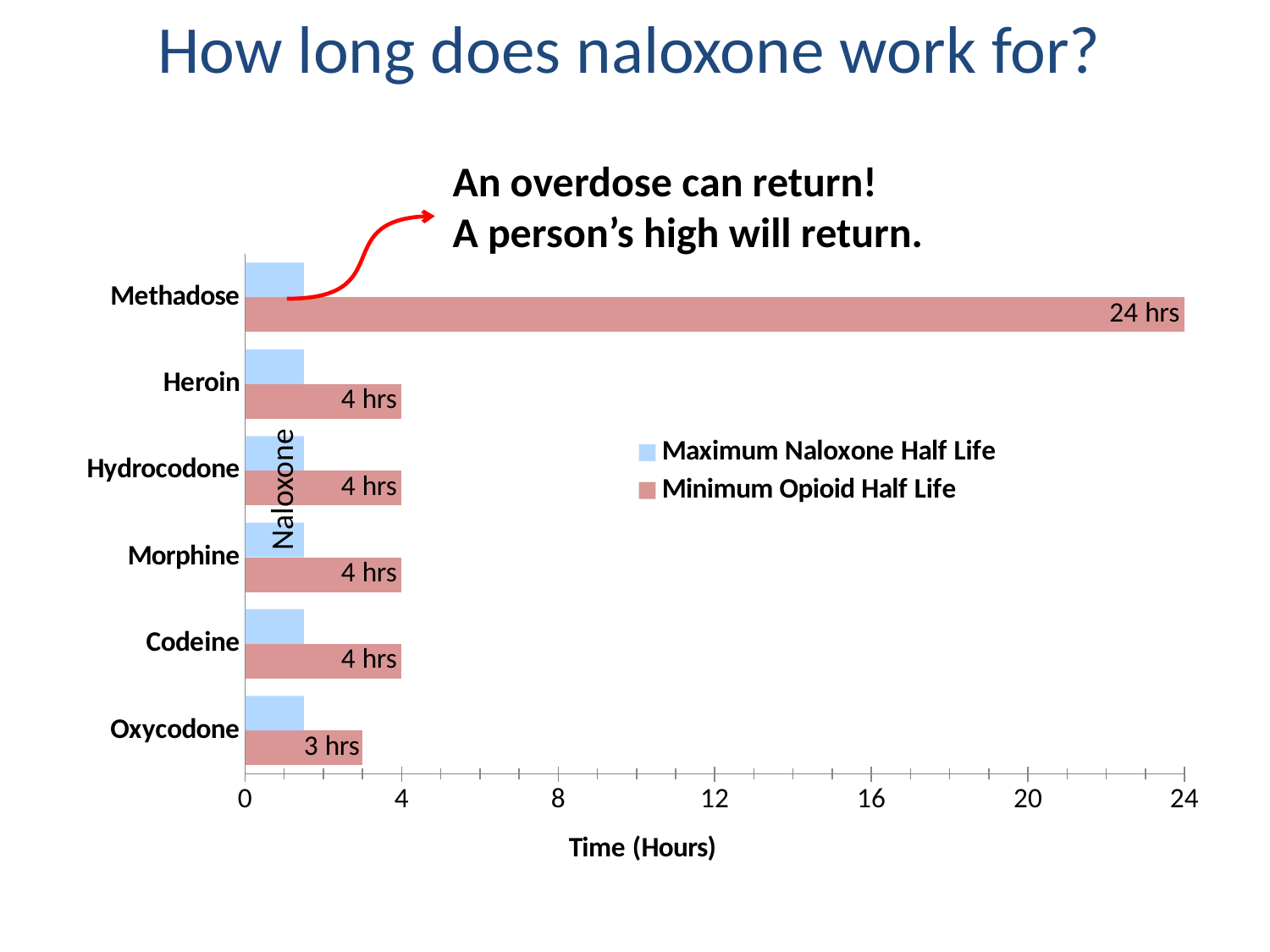
What is the Minimum Opioid Half Life shown for Oxycodone? 3 hrs What is the title of the horizontal axis? Time (Hours) Is the Maximum Naloxone Half Life bar for Methadose greater or less than 4 hours? less How many series does the legend list? 2 How many opioids are listed on the chart? 6 Which has a larger Minimum Opioid Half Life, Methadose or Morphine? Methadose Which opioid has the highest Minimum Opioid Half Life? Methadose Which opioid has the lowest Minimum Opioid Half Life? Oxycodone What is the Minimum Opioid Half Life shown for Heroin? 4 hrs How much longer is the Minimum Opioid Half Life for Methadose than for Heroin? 20 hrs What is the Minimum Opioid Half Life shown for Methadose? 24 hrs What kind of chart is shown on the slide? bar chart